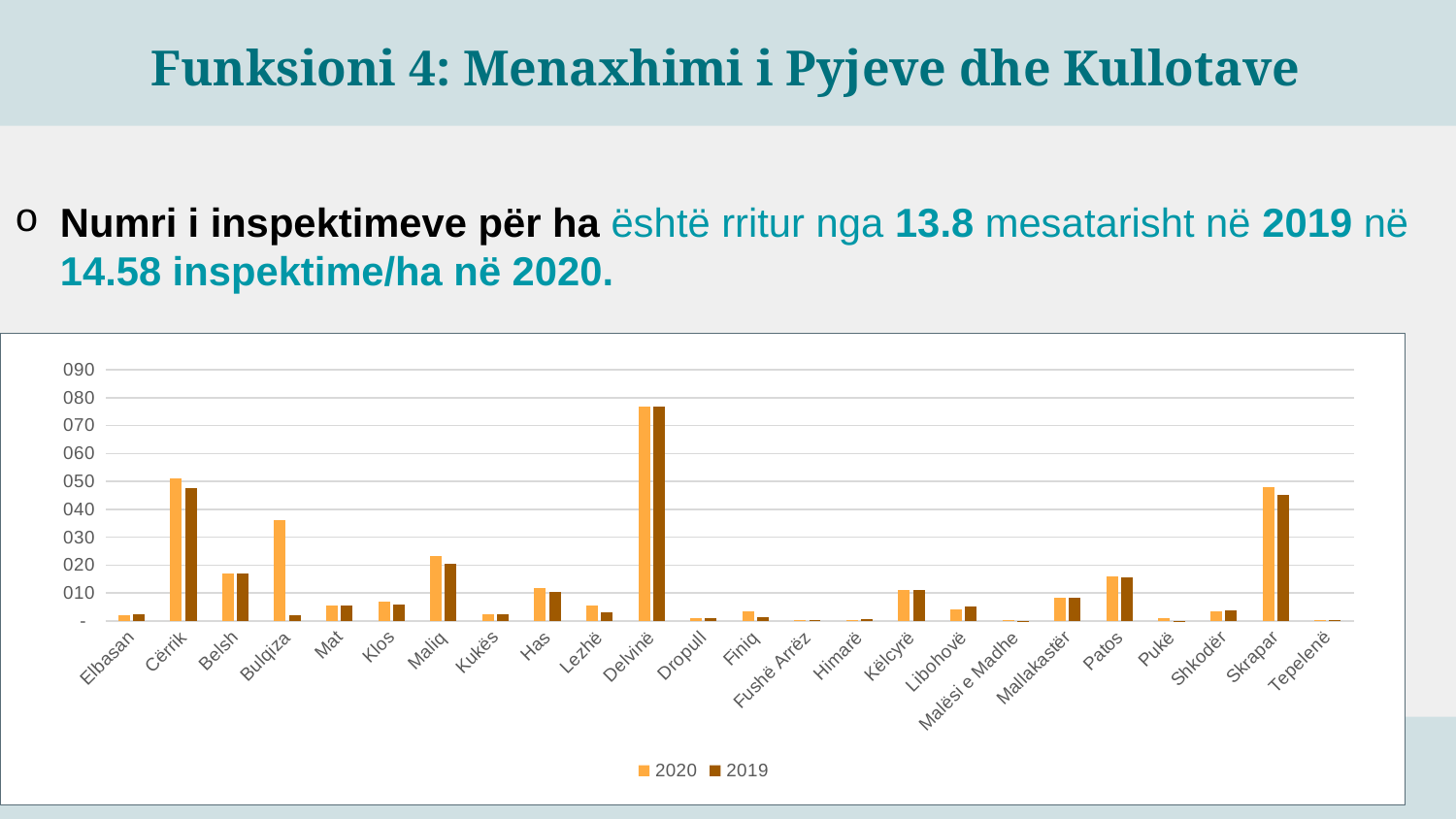
Is the 2020 value for Bulqiza greater or less than 030? greater Which category has the highest value for 2020? Delvinë How many categories (municipalities) are shown on the x axis? 24 Which has the larger 2020 value, Delvinë or Cërrik? Delvinë Is the 2020 value for Delvinë greater or less than 070? greater Which series is shown in the darker brown colour in the legend? 2019 For Bulqiza, which series has the larger value, 2020 or 2019? 2020 How many series does the legend list? 2 What kind of chart is shown on the slide? bar chart Is the 2019 value for Bulqiza greater or less than 010? less Which category has the highest value for 2019? Delvinë